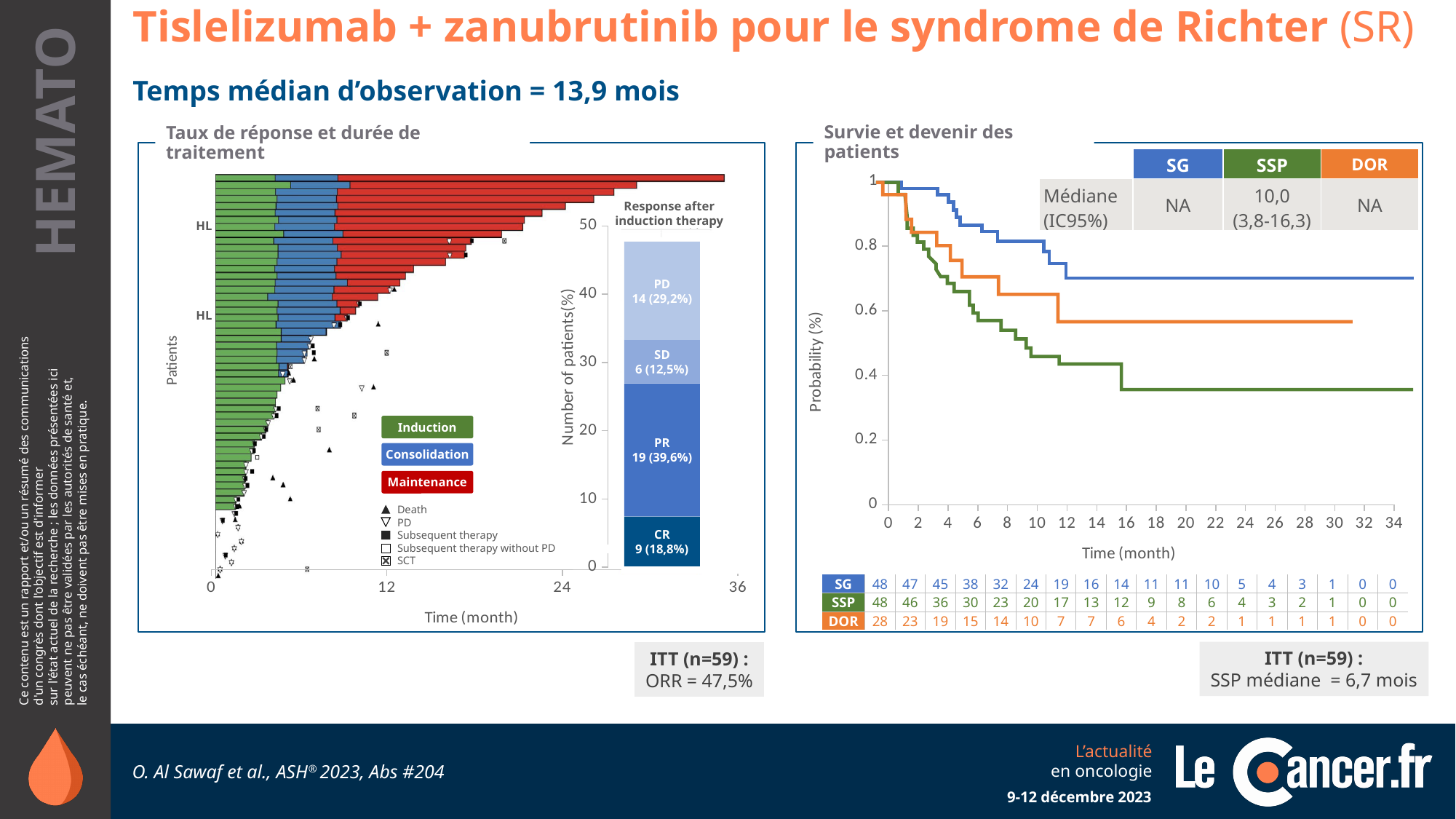
In the 'Response after induction therapy' stacked bar, how many patients had a complete response (CR)? 9 (18,8%) In the 'Survie et devenir des patients' chart, how many SG patients are at risk at 12 months according to the table below the chart? 19 In the 'Response after induction therapy' stacked bar, which response category has the largest number of patients? PR In the 'Response after induction therapy' stacked bar, what is the total number of patients across all four segments? 48 In the 'Survie et devenir des patients' chart, is the SG probability at 20 months greater or less than 0.6? greater In the 'Response after induction therapy' stacked bar, what is the difference between the number of PD patients and SD patients? 8 In the 'Response after induction therapy' stacked bar, how many patients had a partial response (PR)? 19 (39,6%) In the 'Survie et devenir des patients' chart, is the SSP probability at 20 months greater or less than 0.4? less In the 'Survie et devenir des patients' chart, how many series does the legend list? 3 In the 'Response after induction therapy' stacked bar, which response category has the smallest number of patients? SD In the 'Survie et devenir des patients' chart, how many patients are at risk for DOR at time 0 according to the table below the chart? 28 In the 'Survie et devenir des patients' chart, what is the median SSP (IC95%) shown in the table? 10,0 (3,8-16,3)